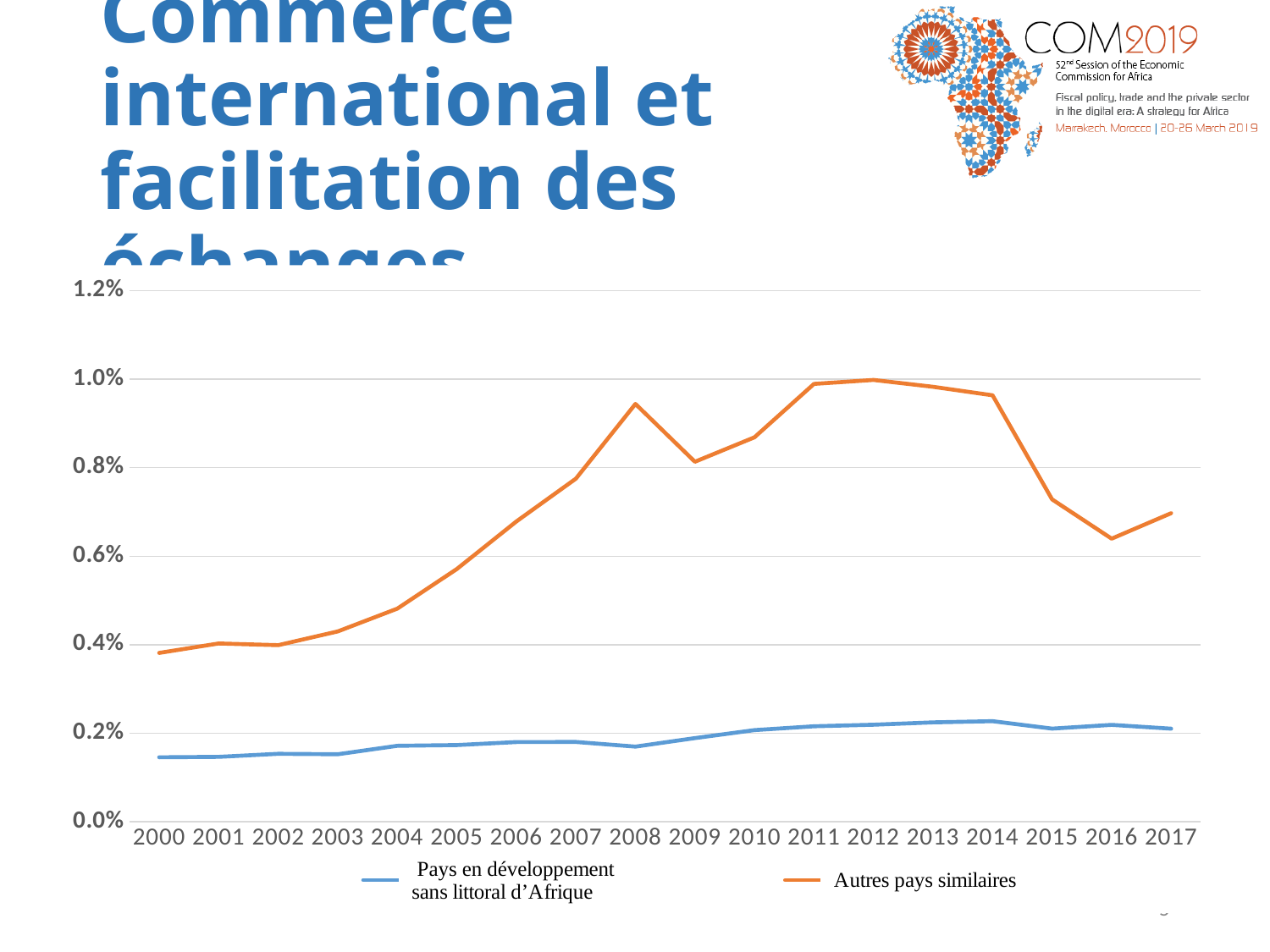
Is the value for Pays en développement sans littoral d'Afrique in 2000 greater or less than 0.2%? less Is the value for Autres pays similaires in 2008 greater or less than 0.8%? greater Is the value for Autres pays similaires in 2000 greater or less than 0.4%? less Does the value for Pays en développement sans littoral d'Afrique rise or fall from 2000 to 2014? rise Does the value for Autres pays similaires rise or fall from 2014 to 2016? fall In 2010, which series has the larger value: Pays en développement sans littoral d'Afrique or Autres pays similaires? Autres pays similaires How many series does the legend list? 2 What kind of chart is shown on the slide? line chart How many years are shown on the x axis? 18 What colour is the line for Autres pays similaires? orange In which year is the value for Autres pays similaires lowest? 2000